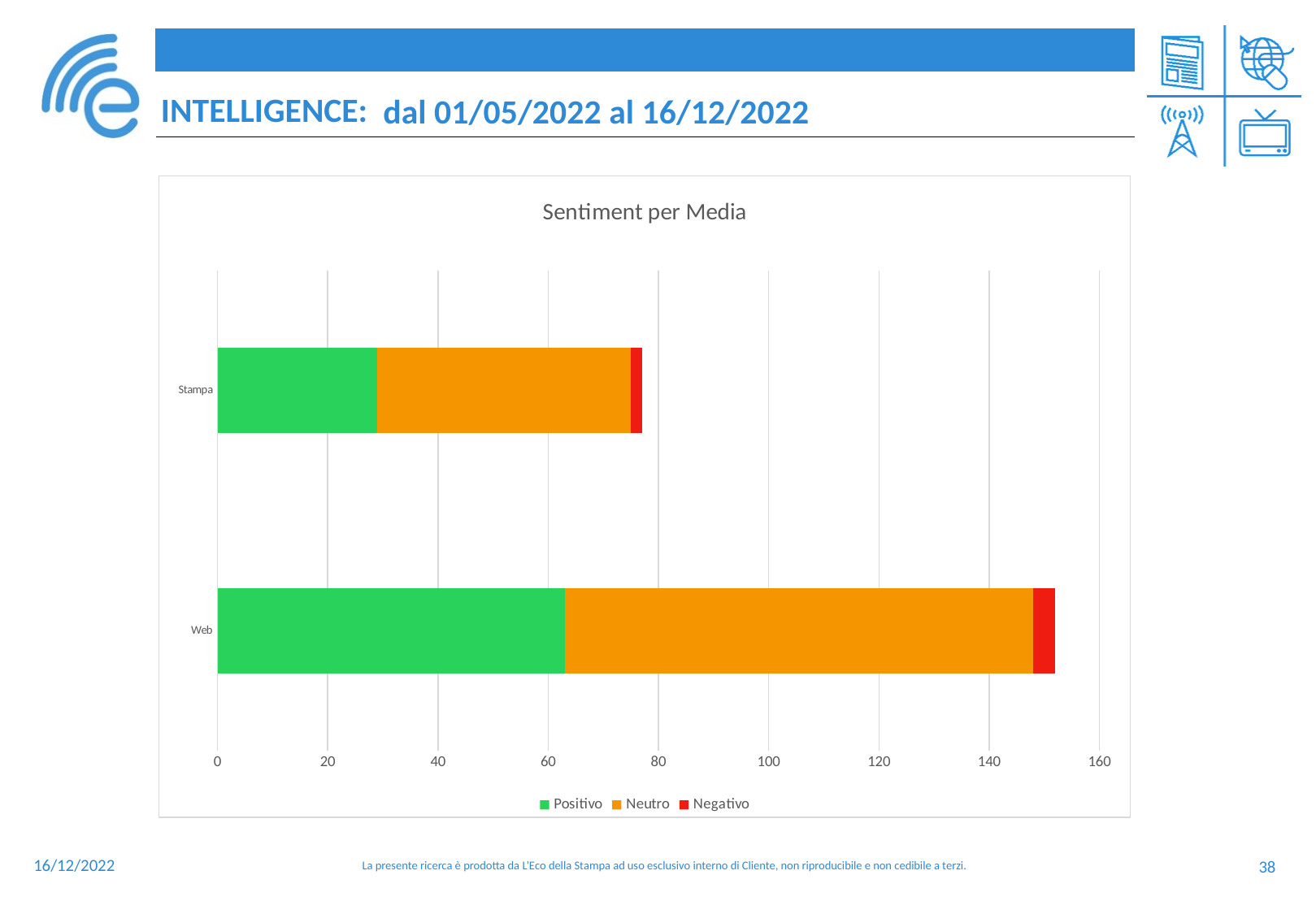
What kind of chart is shown on the slide? stacked bar chart Is the Positivo value for Stampa greater or less than 40? less Which is larger, the Positivo value for Web or the Positivo value for Stampa? Web How many series does the legend list? 3 Which category has the longest total bar? Web How many media categories are plotted on the chart? 2 What is the title of the chart? Sentiment per Media Which series are listed in the legend? Positivo, Neutro, Negativo Which series has the smallest segment in the Web bar? Negativo Is the total bar length for Stampa greater or less than 100? less Is the total bar length for Web greater or less than 140? greater Which category has the shortest total bar? Stampa